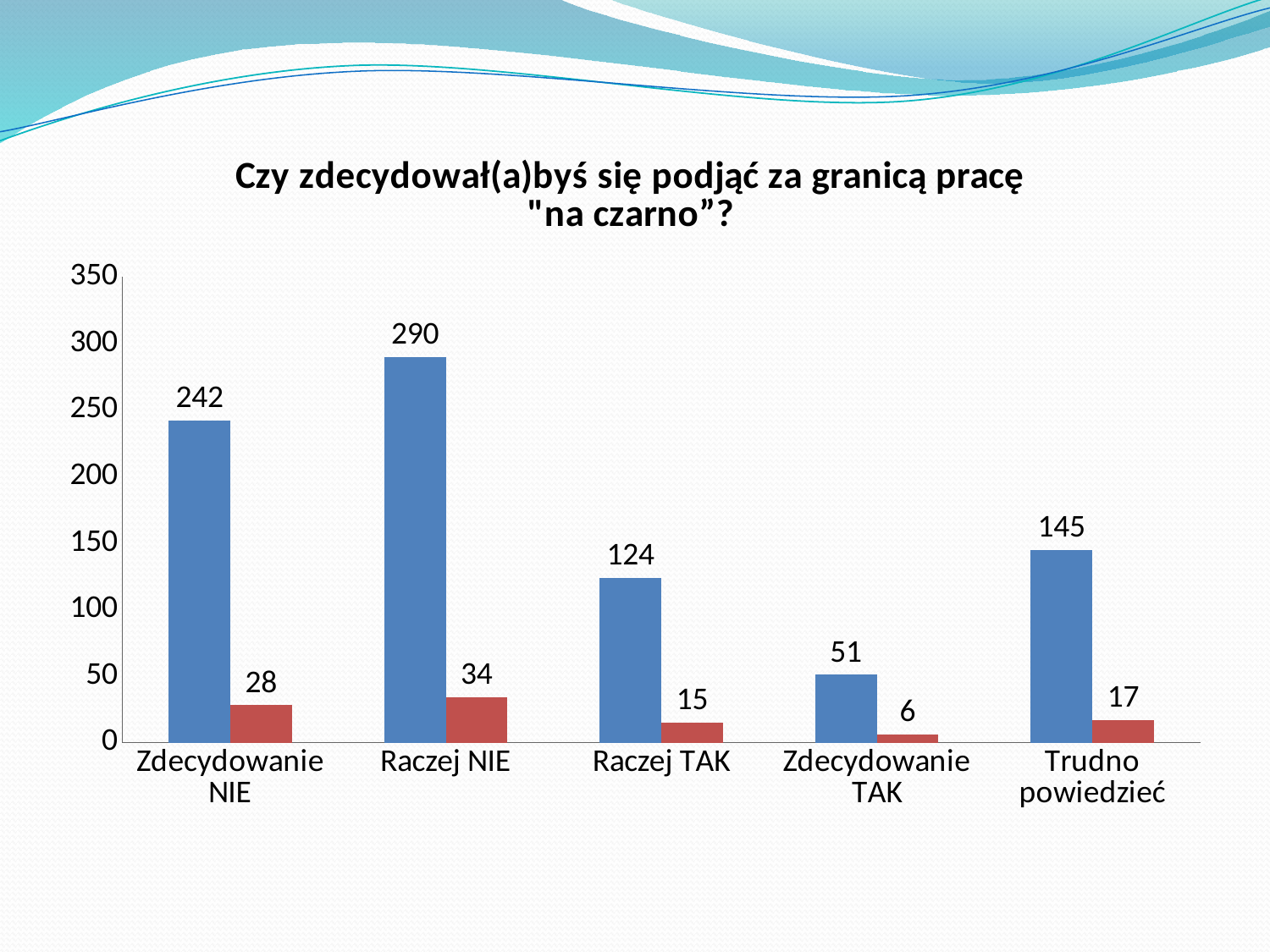
What is the value of the red bar for "Zdecydowanie TAK"? 6 What is the title of the chart? Czy zdecydował(a)byś się podjąć za granicą pracę "na czarno"? How many categories are shown on the x axis? 5 Which is larger: the red bar for "Zdecydowanie NIE" or the red bar for "Raczej NIE"? Raczej NIE What type of chart is shown on the slide? bar chart Which category has the lowest red bar? Zdecydowanie TAK What is the value of the blue bar for "Raczej NIE"? 290 What is the value of the blue bar for "Trudno powiedzieć"? 145 What is the difference between the blue bars for "Raczej NIE" and "Zdecydowanie NIE"? 48 Which category has the highest blue bar? Raczej NIE Is the blue bar for "Zdecydowanie TAK" greater or less than 100? less What is the difference between the blue and red bars for "Raczej TAK"? 109